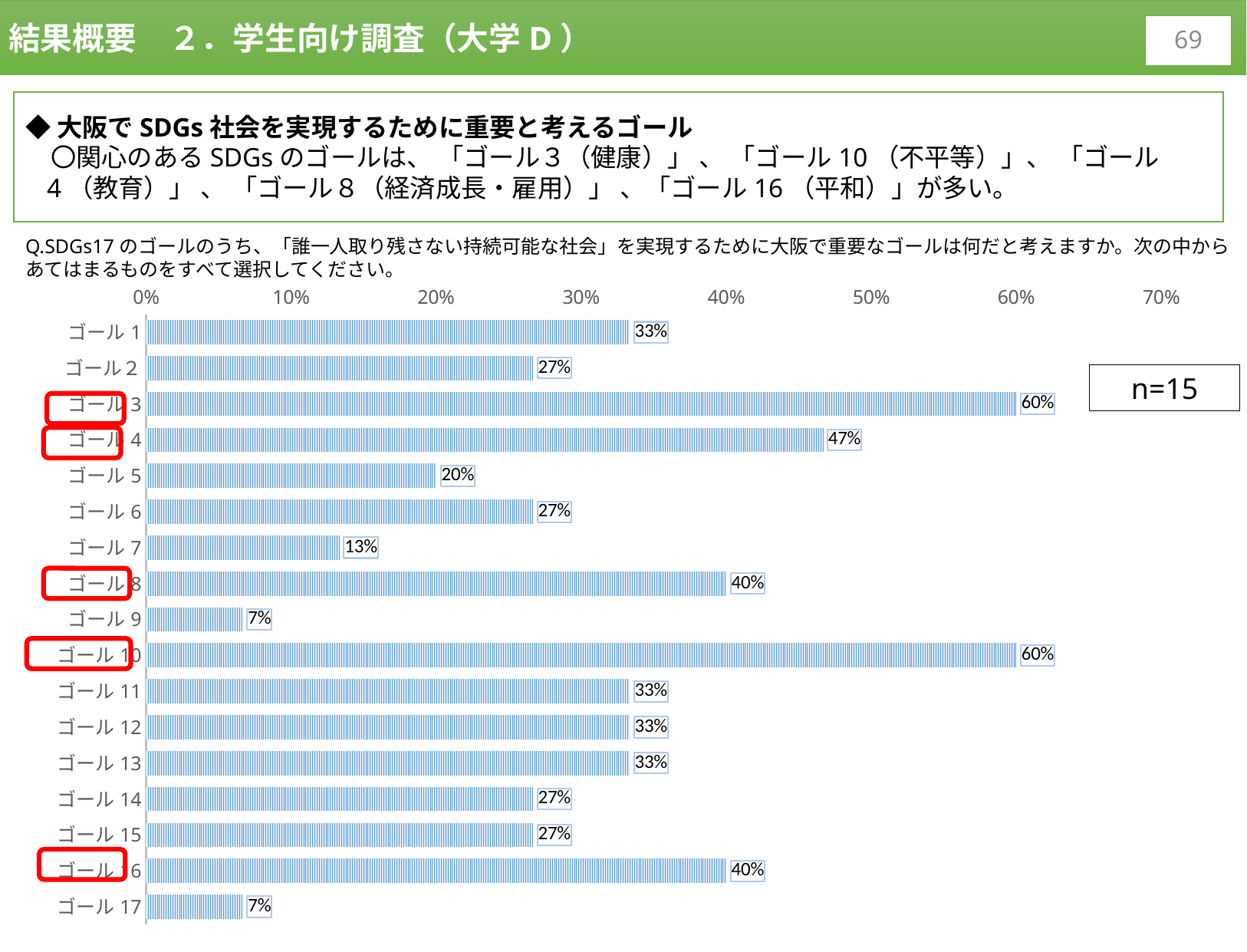
What is the difference between the values for ゴール 1 and ゴール 2? 6% Which is larger, the value for ゴール 8 or the value for ゴール 5? ゴール 8 What is the difference between the values for ゴール 3 and ゴール 4? 13% How many categories are shown in the chart? 17 What is the value for ゴール 9? 7% Which category has the lowest value? ゴール 9 and ゴール 17 (7%) What kind of chart is shown on the slide? bar chart What is the value for ゴール 4? 47% What is the sample size (n) shown next to the chart? n=15 Is the value for ゴール 7 greater or less than 20%? less What is the value for ゴール 16? 40% What is the value for ゴール 3? 60%